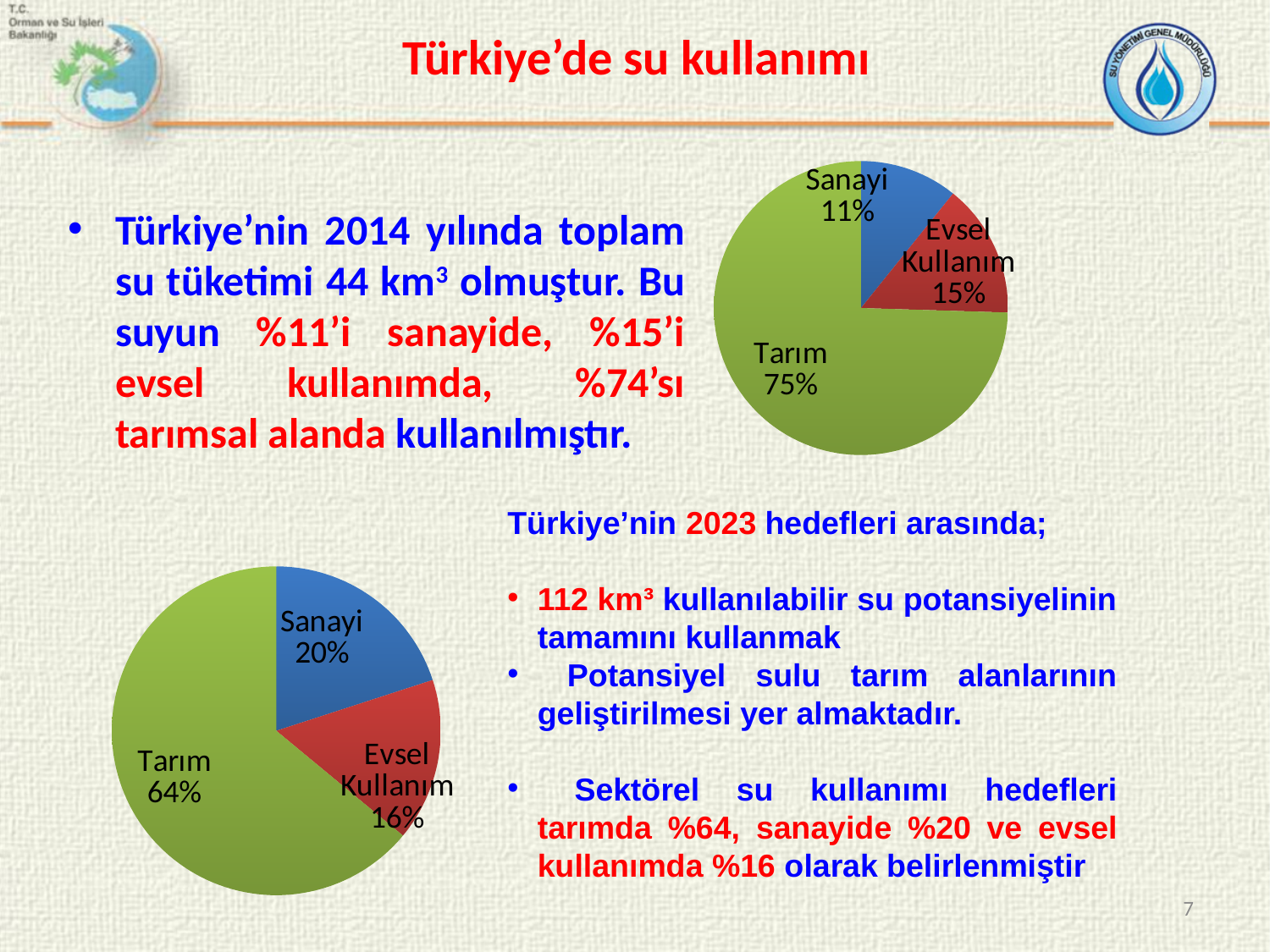
In the pie chart at the top right of the slide, which category has the smallest slice? Sanayi What is the difference in percentage points between the Tarım share in the top-right pie chart and the Tarım share in the bottom-left pie chart? 11 In the pie chart at the bottom left of the slide, what share is labelled for Evsel Kullanım? 16% In the pie chart at the top right of the slide, which category has the largest slice? Tarım In the pie chart at the top right of the slide, what share is labelled for Evsel Kullanım? 15% In the pie chart at the bottom left of the slide, which is larger, the Sanayi slice or the Evsel Kullanım slice? Sanayi What type of chart is shown at the bottom left of the slide? Pie chart In the pie chart at the bottom left of the slide, what share is labelled for Tarım? 64% In the pie chart at the top right of the slide, how many slices are there? 3 In the pie chart at the top right of the slide, what share is labelled for Sanayi? 11% In the pie chart at the top right of the slide, what share is labelled for Tarım? 75% In the pie chart at the bottom left of the slide, what share is labelled for Sanayi? 20%